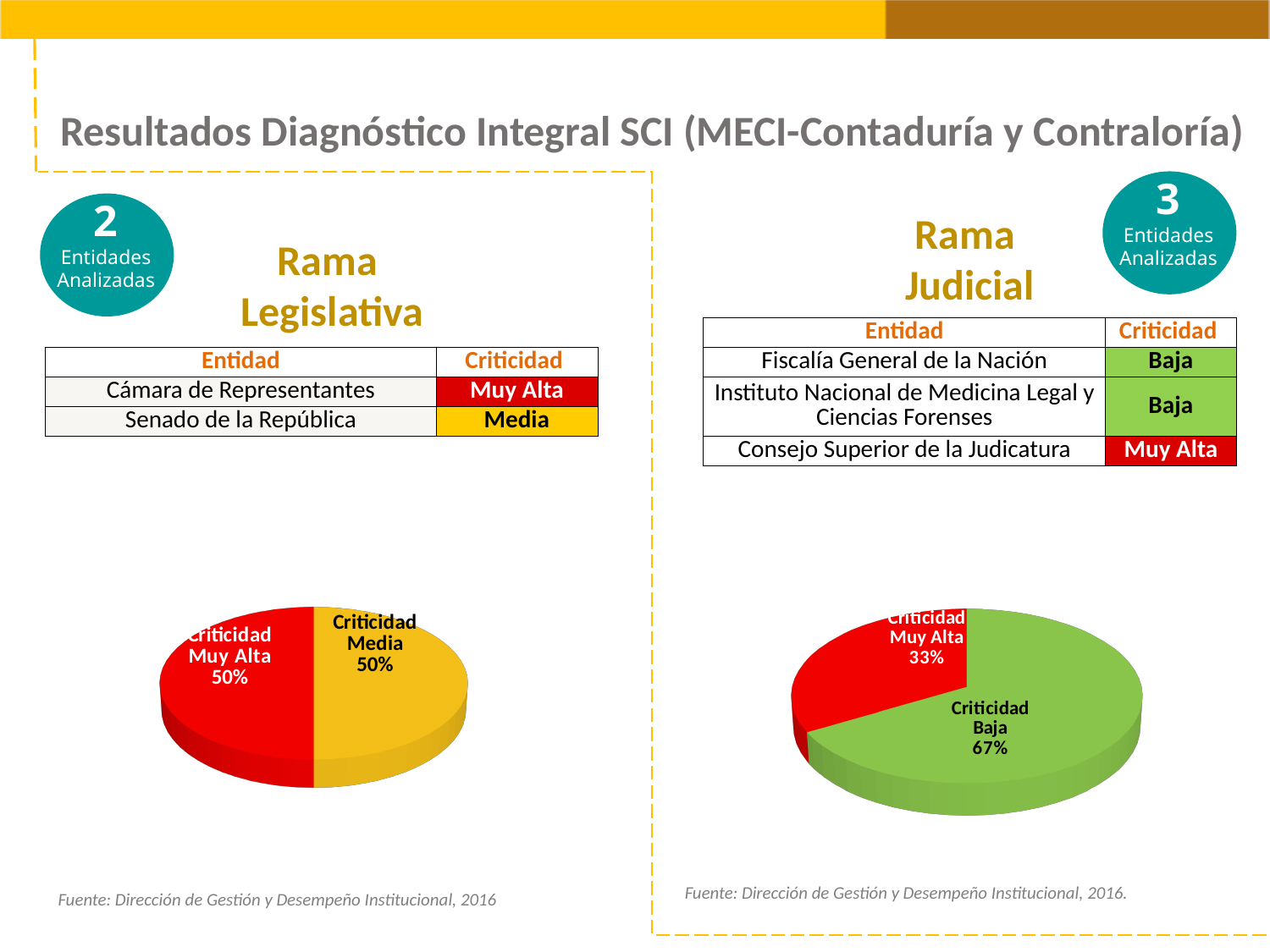
In the Rama Judicial pie chart on the right, what share does Criticidad Muy Alta have? 33% In the Rama Legislativa pie chart on the left, what share does Criticidad Muy Alta have? 50% What colour is the Criticidad Muy Alta slice in the Rama Legislativa pie chart on the left? red In the Rama Judicial pie chart on the right, which slice is the largest? Criticidad Baja What kind of chart is shown under Rama Legislativa on the left of the slide? pie chart How many slices does the Rama Legislativa pie chart on the left have? 2 In the Rama Judicial pie chart on the right, which slice is the smallest? Criticidad Muy Alta In the Rama Judicial pie chart on the right, what share does Criticidad Baja have? 67% How many slices does the Rama Judicial pie chart on the right have? 2 In the Rama Judicial pie chart on the right, what is the difference between the Criticidad Baja share and the Criticidad Muy Alta share? 34% In the Rama Judicial pie chart on the right, which is larger: Criticidad Baja or Criticidad Muy Alta? Criticidad Baja